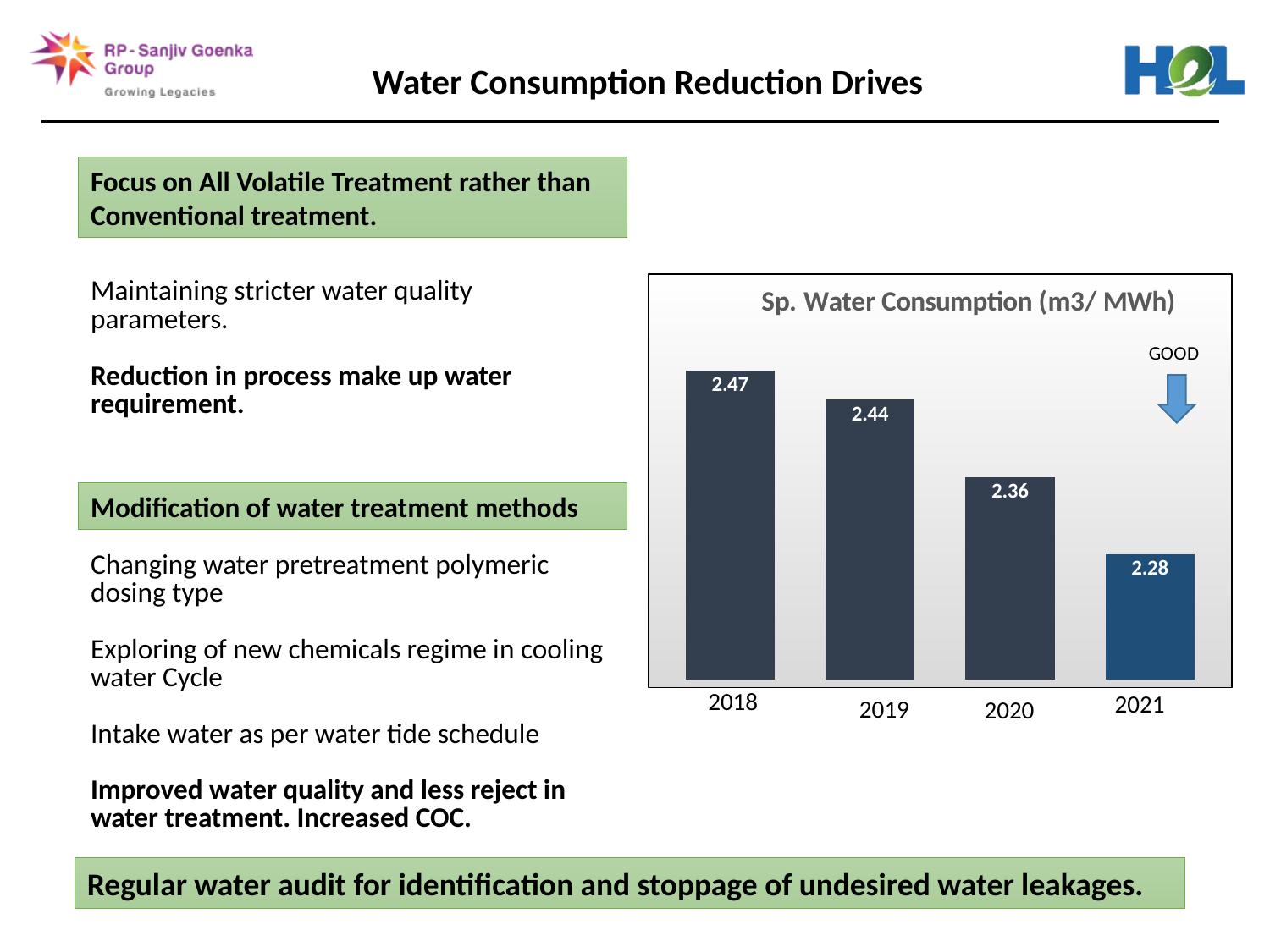
Which year has the highest Sp. Water Consumption? 2018 What is the Sp. Water Consumption value for 2020? 2.36 What kind of chart is used to show Sp. Water Consumption? Bar chart What is the difference in Sp. Water Consumption between 2018 and 2021? 0.19 What is the difference in Sp. Water Consumption between 2019 and 2020? 0.08 What is the Sp. Water Consumption value for 2021? 2.28 Which year has a higher Sp. Water Consumption, 2019 or 2020? 2019 What is the title of the chart on the slide? Sp. Water Consumption (m3/ MWh) Which year has the lowest Sp. Water Consumption? 2021 Does Sp. Water Consumption rise or fall from 2018 to 2021? Fall How many years are shown in the Sp. Water Consumption chart? 4 What is the Sp. Water Consumption value for 2018? 2.47